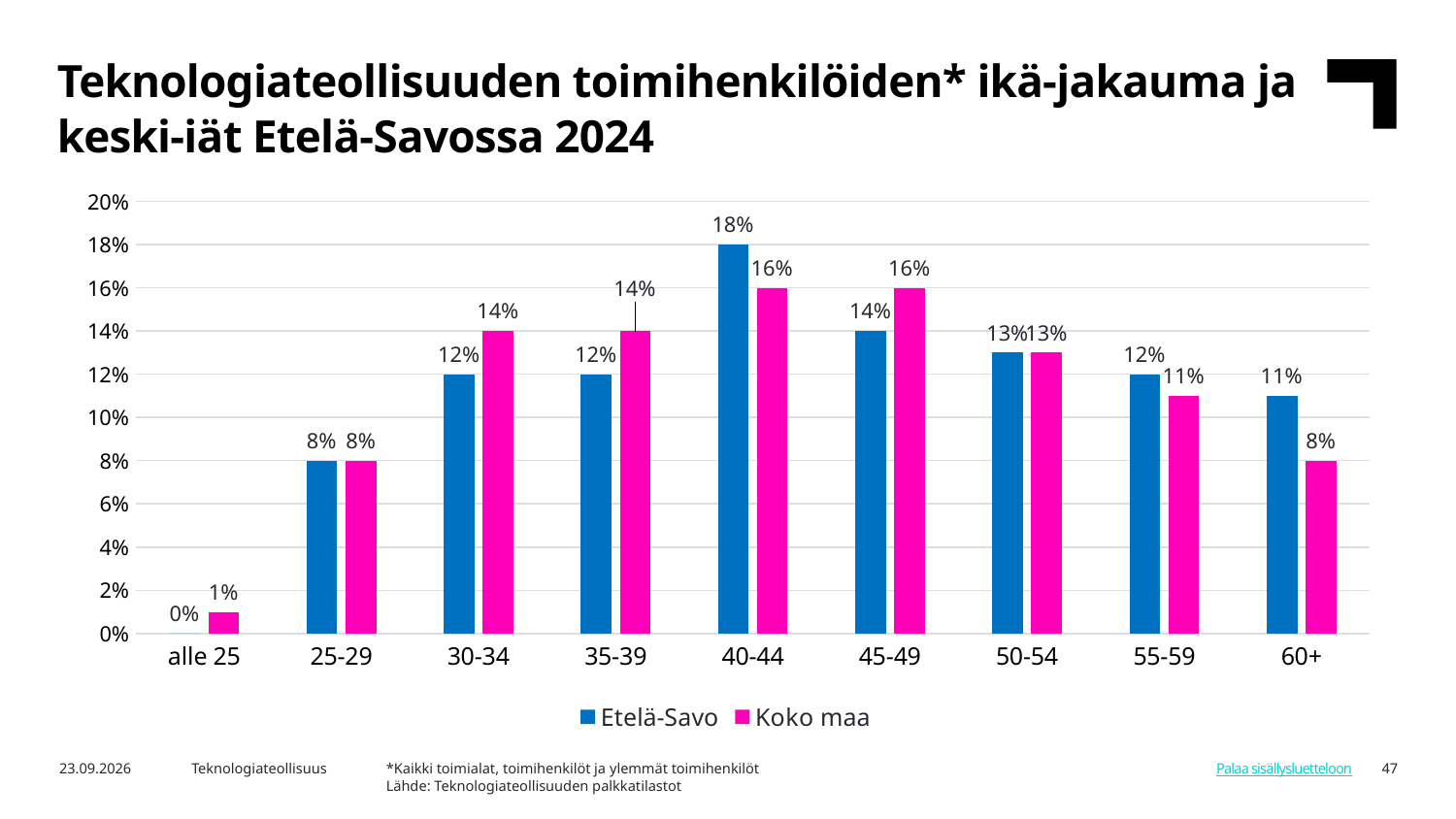
Which age group has the highest Etelä-Savo value? 40-44 What is the difference between the Koko maa values for the 40-44 and 30-34 age groups? 2% What is the difference between the Etelä-Savo and Koko maa values for the 60+ age group? 3% What is the Koko maa value for the alle 25 age group? 1% For the 45-49 age group, which series has the larger value, Etelä-Savo or Koko maa? Koko maa What is the Etelä-Savo value for the 40-44 age group? 18% What is the Koko maa value for the 60+ age group? 8% How many age groups are shown on the x axis? 9 Which colour represents the Koko maa series in the chart? magenta (pink) How many series does the legend list? 2 Which age group has the lowest Etelä-Savo value? alle 25 What kind of chart is shown on the slide? bar chart